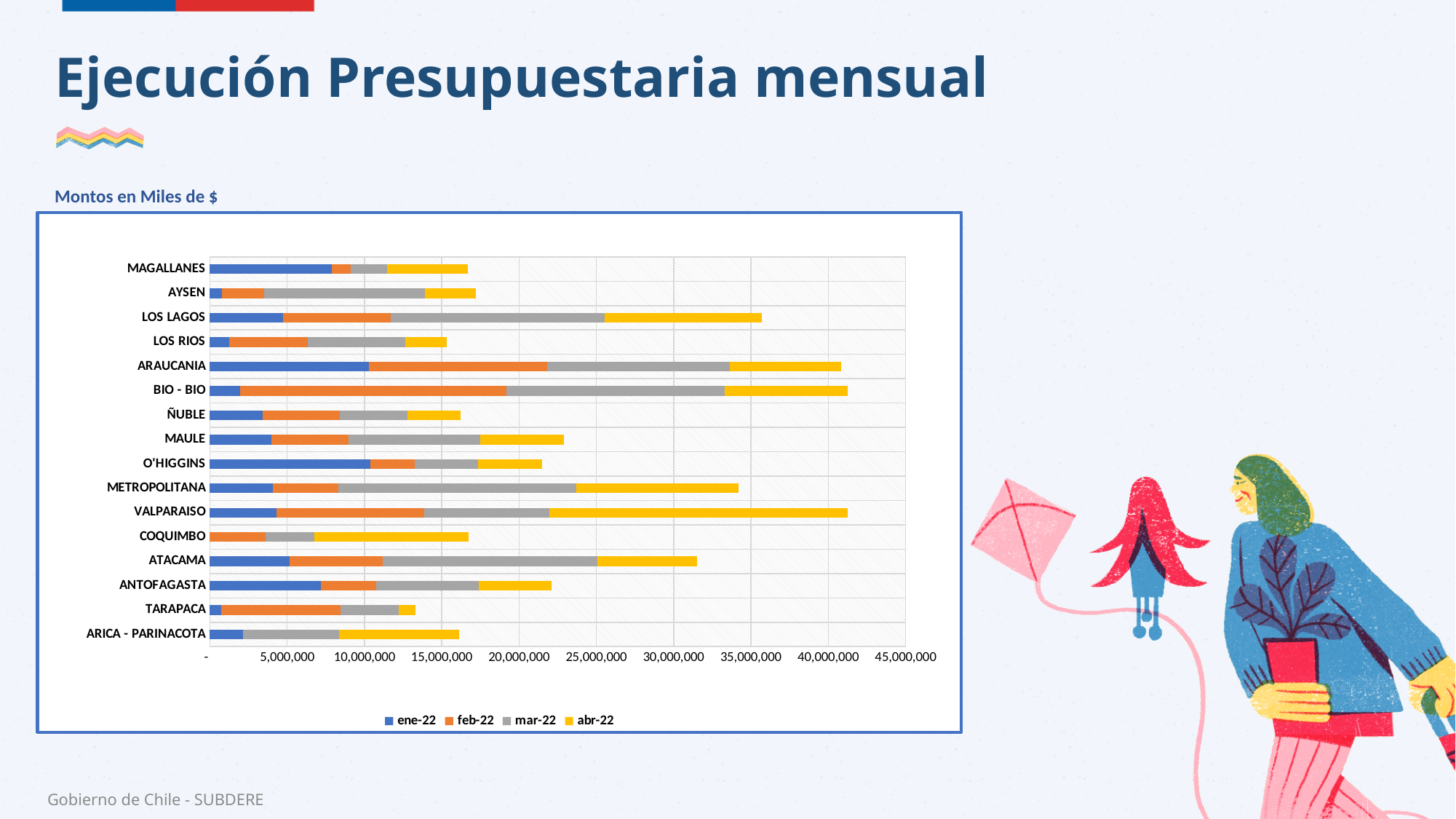
Is the total stacked bar for LOS LAGOS greater or less than 30,000,000? greater Is the total stacked bar for METROPOLITANA greater or less than 30,000,000? greater How many regions (categories) are plotted on the chart? 16 What are the series names listed in the legend? ene-22, feb-22, mar-22, abr-22 What unit note is shown above the chart? Montos en Miles de $ Which region has the larger total stacked bar, LOS LAGOS or AYSEN? LOS LAGOS Is the total stacked bar for COQUIMBO greater or less than 20,000,000? less How many series does the chart legend list? 4 Which region has the shortest total stacked bar? TARAPACA Which region has the larger total stacked bar, ARAUCANIA or MAULE? ARAUCANIA What kind of chart is shown on the slide? Stacked bar chart